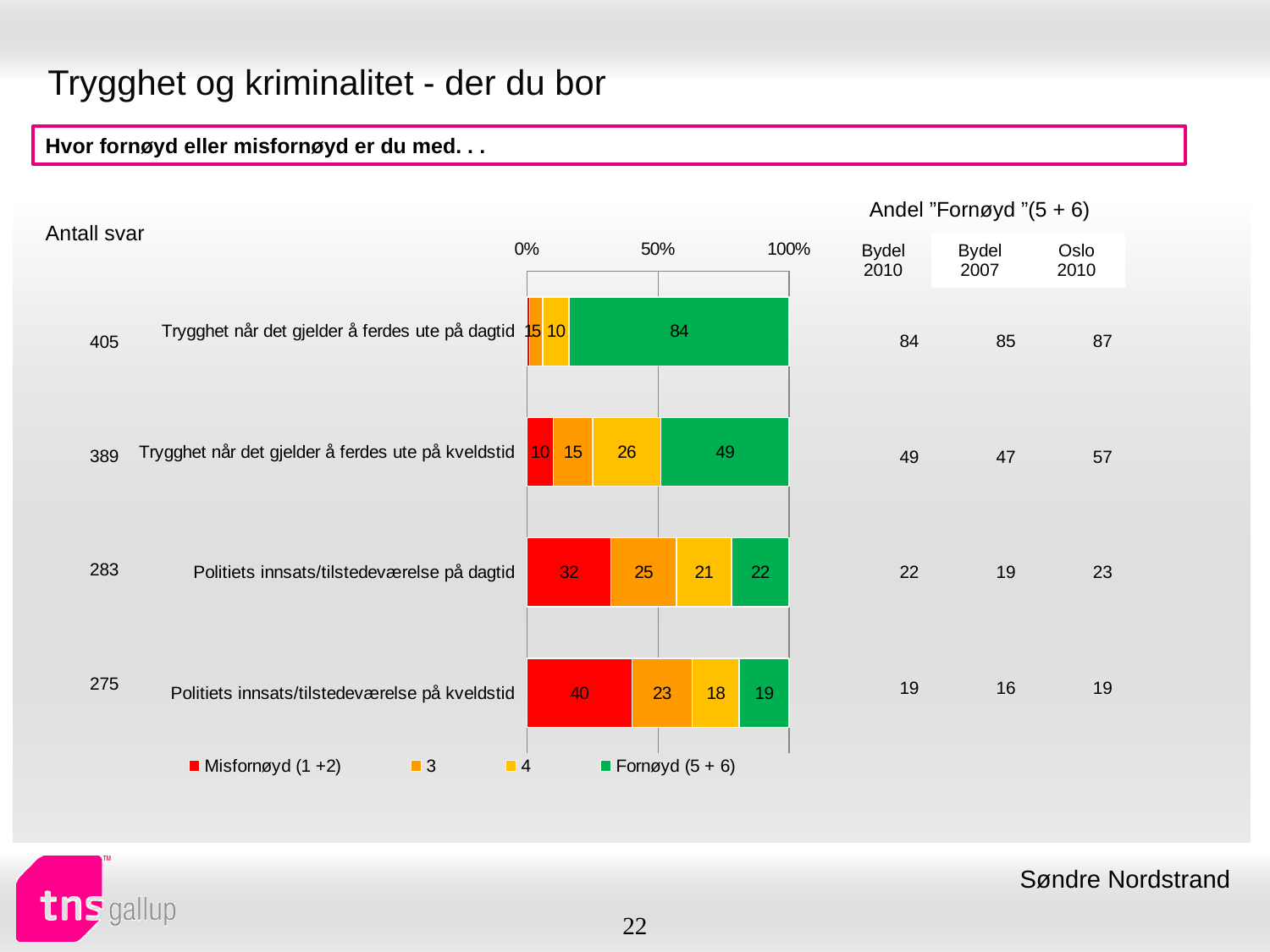
Which category has the lowest 'Fornøyd (5 + 6)' value? Politiets innsats/tilstedeværelse på kveldstid What is the 'Fornøyd (5 + 6)' value for 'Trygghet når det gjelder å ferdes ute på dagtid'? 84 What is the value of series '4' for 'Trygghet når det gjelder å ferdes ute på kveldstid'? 26 Which is larger: the 'Fornøyd (5 + 6)' value for 'Trygghet når det gjelder å ferdes ute på kveldstid' or for 'Politiets innsats/tilstedeværelse på dagtid'? Trygghet når det gjelder å ferdes ute på kveldstid What is the value of series '3' for 'Politiets innsats/tilstedeværelse på dagtid'? 25 Which category has the highest 'Fornøyd (5 + 6)' value? Trygghet når det gjelder å ferdes ute på dagtid What is the 'Misfornøyd (1 +2)' value for 'Politiets innsats/tilstedeværelse på kveldstid'? 40 What is the difference between the 'Misfornøyd (1 +2)' values for 'Politiets innsats/tilstedeværelse på kveldstid' and 'Politiets innsats/tilstedeværelse på dagtid'? 8 How many series does the chart legend list? 4 How many categories are plotted in the chart? 4 What colour represents the 'Fornøyd (5 + 6)' series in the chart? green What kind of chart is shown on the slide? stacked bar chart